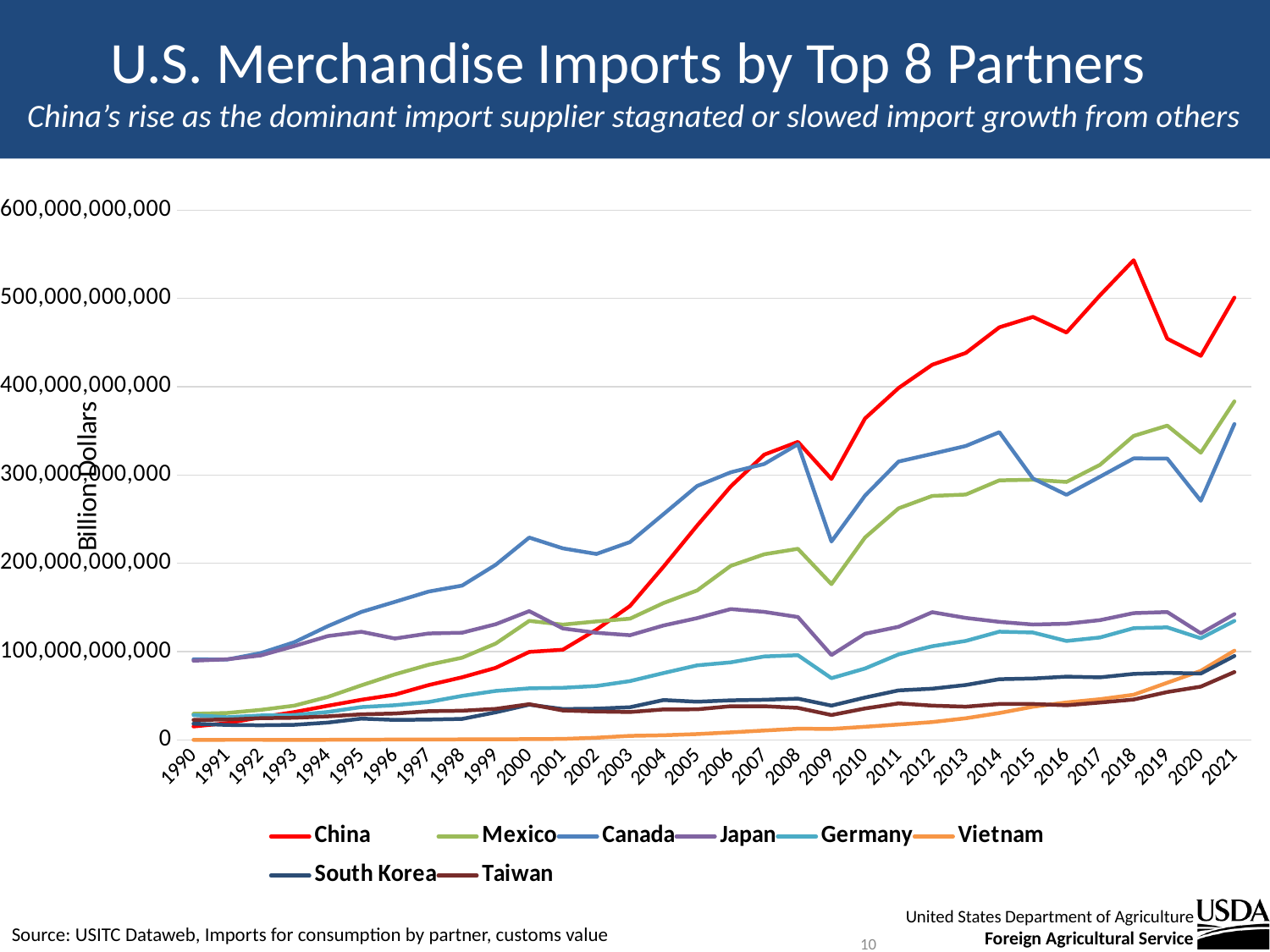
Which partner has the lowest import value in 1990? Vietnam Does the value for China generally rise or fall from 1990 to 2021? rise In 2021, which is larger: the value for China or the value for Canada? China Is the value for Canada in 2009 greater or less than 200,000,000,000? greater What is the title of the chart on the slide? U.S. Merchandise Imports by Top 8 Partners How many years are plotted along the x axis? 32 How many series does the legend list? 8 What kind of chart is shown on the slide? line chart Which partner has the highest import value in 2021? China Is the value for Japan in 2021 greater or less than 200,000,000,000? less Is the value for Vietnam in 2010 greater or less than 100,000,000,000? less